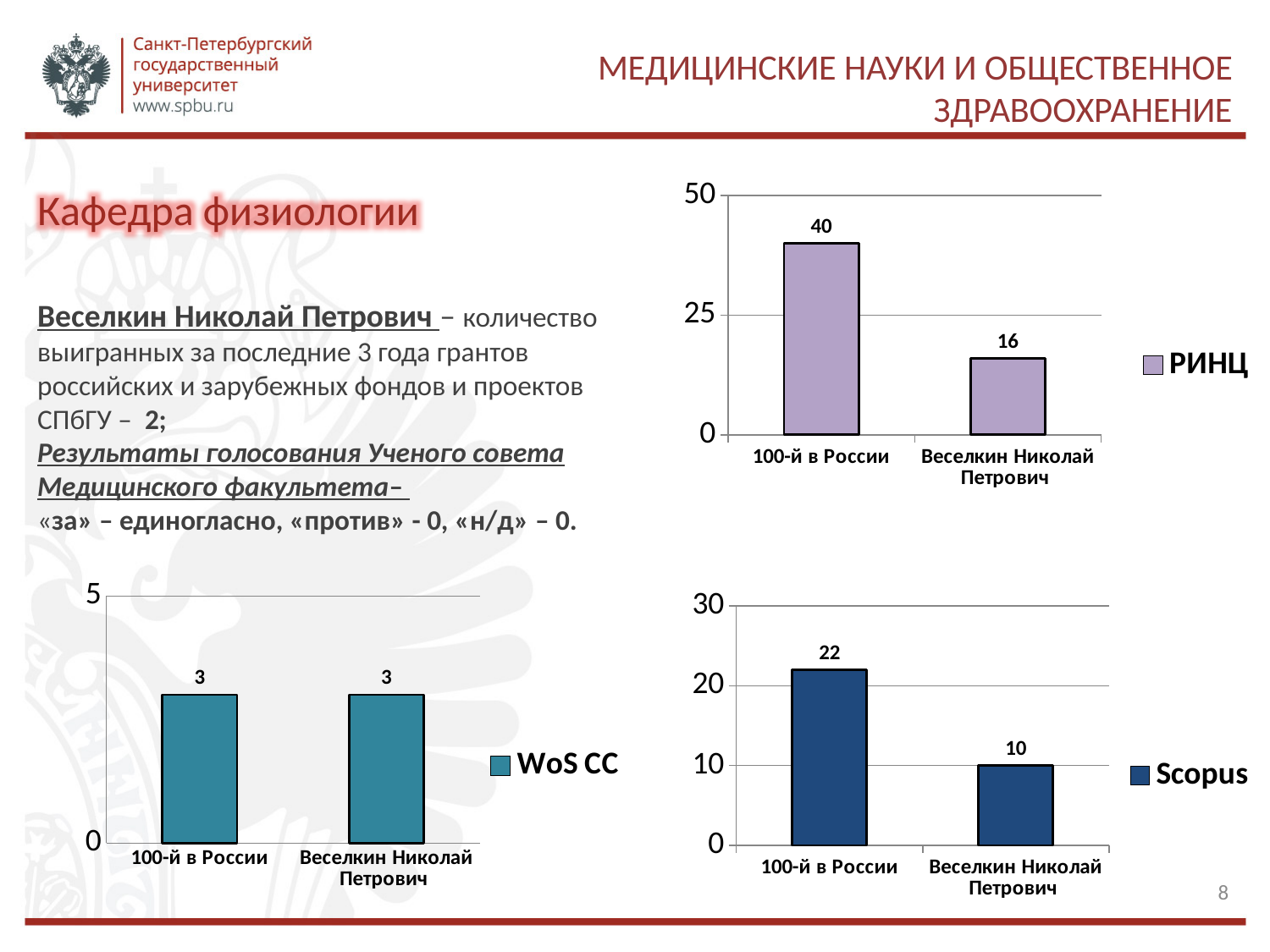
In the WoS CC chart (bottom left), what is the value for Веселкин Николай Петрович? 3 In the РИНЦ chart (top right), what is the value for 100-й в России? 40 In the Scopus chart (bottom right), what is the value for Веселкин Николай Петрович? 10 In the РИНЦ chart (top right), which category has the higher value? 100-й в России In the Scopus chart (bottom right), what is the value for 100-й в России? 22 In the Scopus chart (bottom right), which category has the lower value? Веселкин Николай Петрович How many categories are shown in the Scopus chart (bottom right)? 2 In the РИНЦ chart (top right), what is the difference between the values for 100-й в России and Веселкин Николай Петрович? 24 In the РИНЦ chart (top right), what is the value for Веселкин Николай Петрович? 16 In the Scopus chart (bottom right), is the value for 100-й в России greater or less than 20? greater In the WoS CC chart (bottom left), what is the difference between the values for 100-й в России and Веселкин Николай Петрович? 0 What kind of chart is the WoS CC chart (bottom left)? bar chart